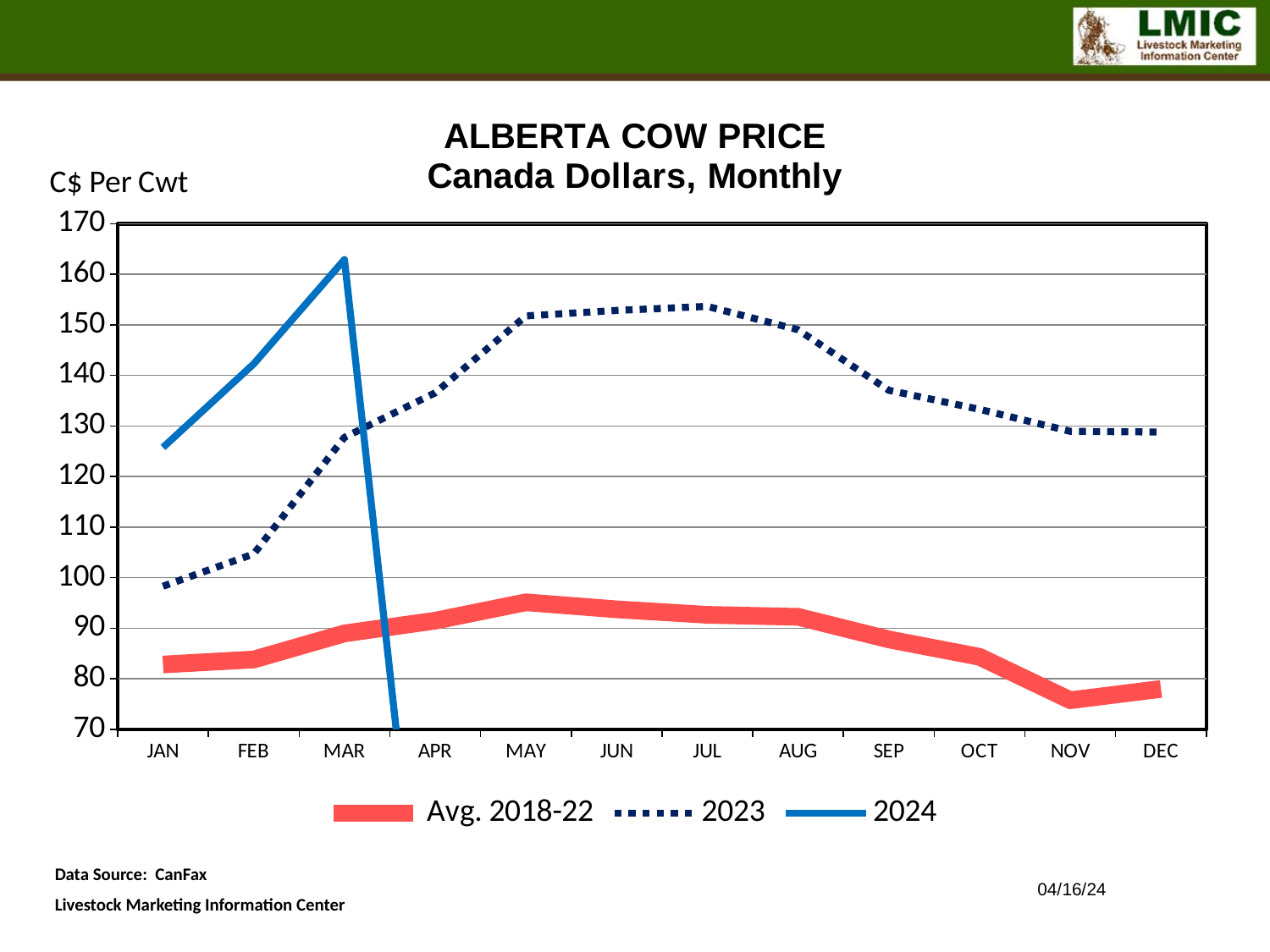
In which month is the Avg. 2018-22 series at its highest? MAY Is the 2023 value for SEP greater or less than 130? greater In FEB, which series has the higher value, 2023 or 2024? 2024 Is the 2024 value for MAR greater or less than 150? greater Is the 2023 value for JAN greater or less than 110? less How many months are shown along the x axis? 12 How many series does the legend list? 3 What kind of chart is shown on the slide? line chart In which month is the 2023 series at its lowest? JAN Does the 2023 series rise or fall from AUG to DEC? fall What unit label is shown above the y axis? C$ Per Cwt